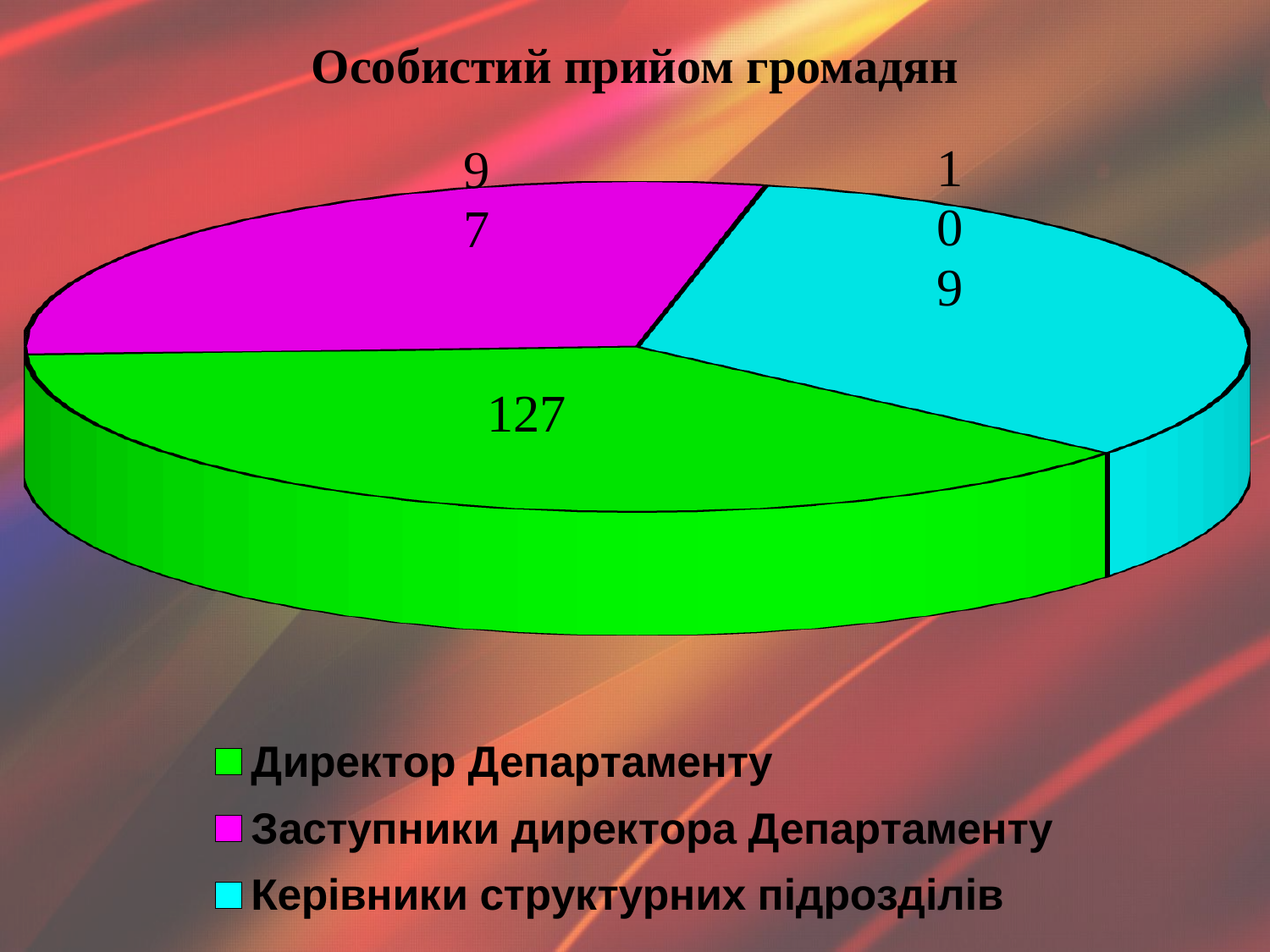
What is the value for Керівники структурних підрозділів? 109 How many entries does the legend list? 3 Which category has the smallest slice? Заступники директора Департаменту How many slices does the pie chart have? 3 What is the difference between the values for Директор Департаменту and Заступники директора Департаменту? 30 What kind of chart is shown on the slide? pie chart What is the value for Заступники директора Департаменту? 97 What is the title of the pie chart? Особистий прийом громадян What colour is the slice for Керівники структурних підрозділів? cyan Which category has the largest slice? Директор Департаменту Which is larger, the value for Керівники структурних підрозділів or the value for Заступники директора Департаменту? Керівники структурних підрозділів What is the value for Директор Департаменту? 127